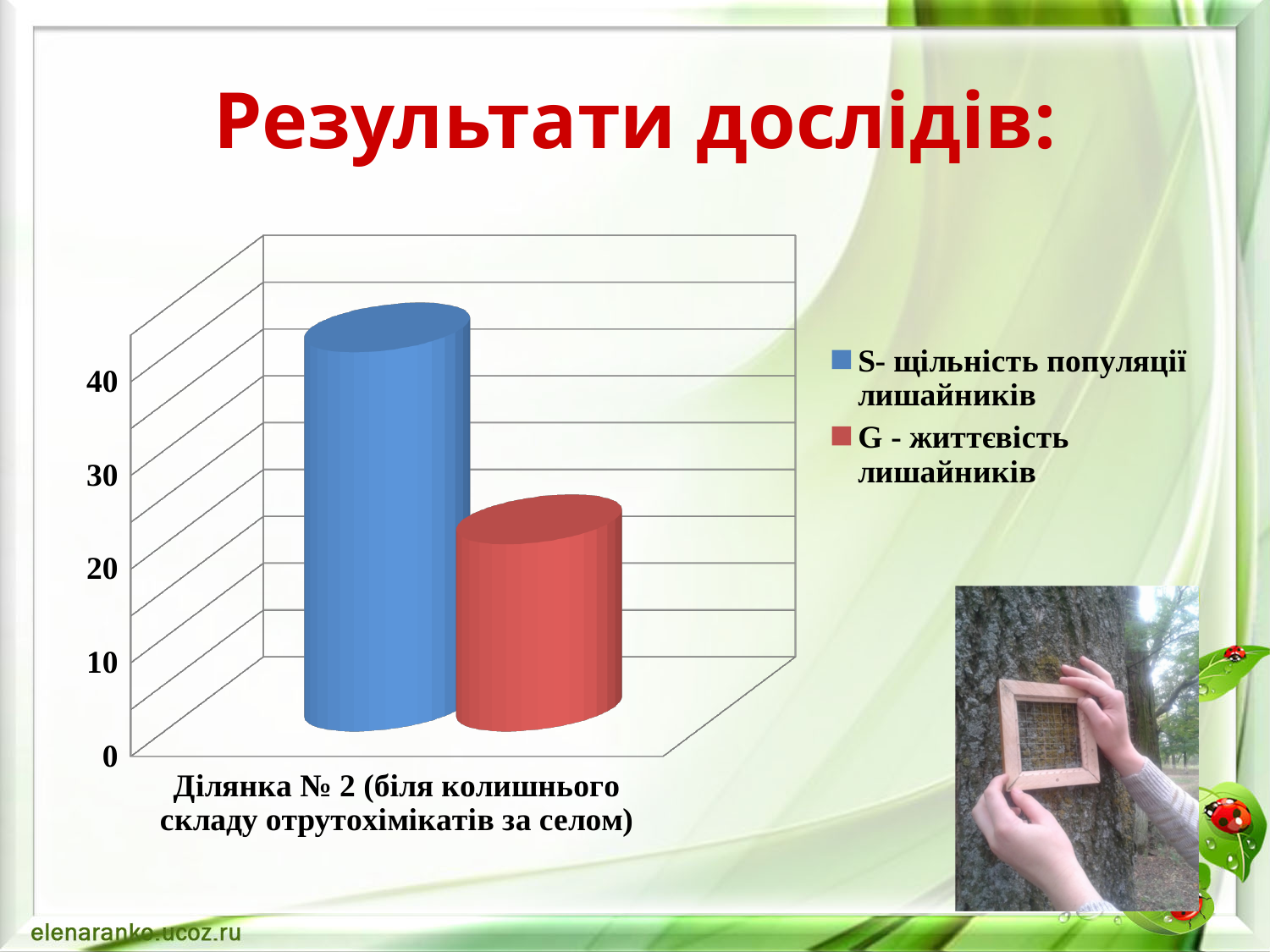
What kind of chart is shown on the slide? bar chart How many series does the chart legend list? 2 What is the category label shown under the bars? Ділянка № 2 (біля колишнього складу отрутохімікатів за селом) Is the value for S- щільність популяції лишайників greater or less than 30? greater Which series has the lowest value in the chart? G - життєвість лишайників Which series has the highest value in the chart? S- щільність популяції лишайників Which series has the higher value for Ділянка № 2: S- щільність популяції лишайників or G - життєвість лишайників? S- щільність популяції лишайників What colour is the bar for S- щільність популяції лишайників? blue Is the value for G - життєвість лишайників greater or less than 10? greater Is the value for G - життєвість лишайників greater or less than 40? less How many categories are shown on the x axis of the chart? 1